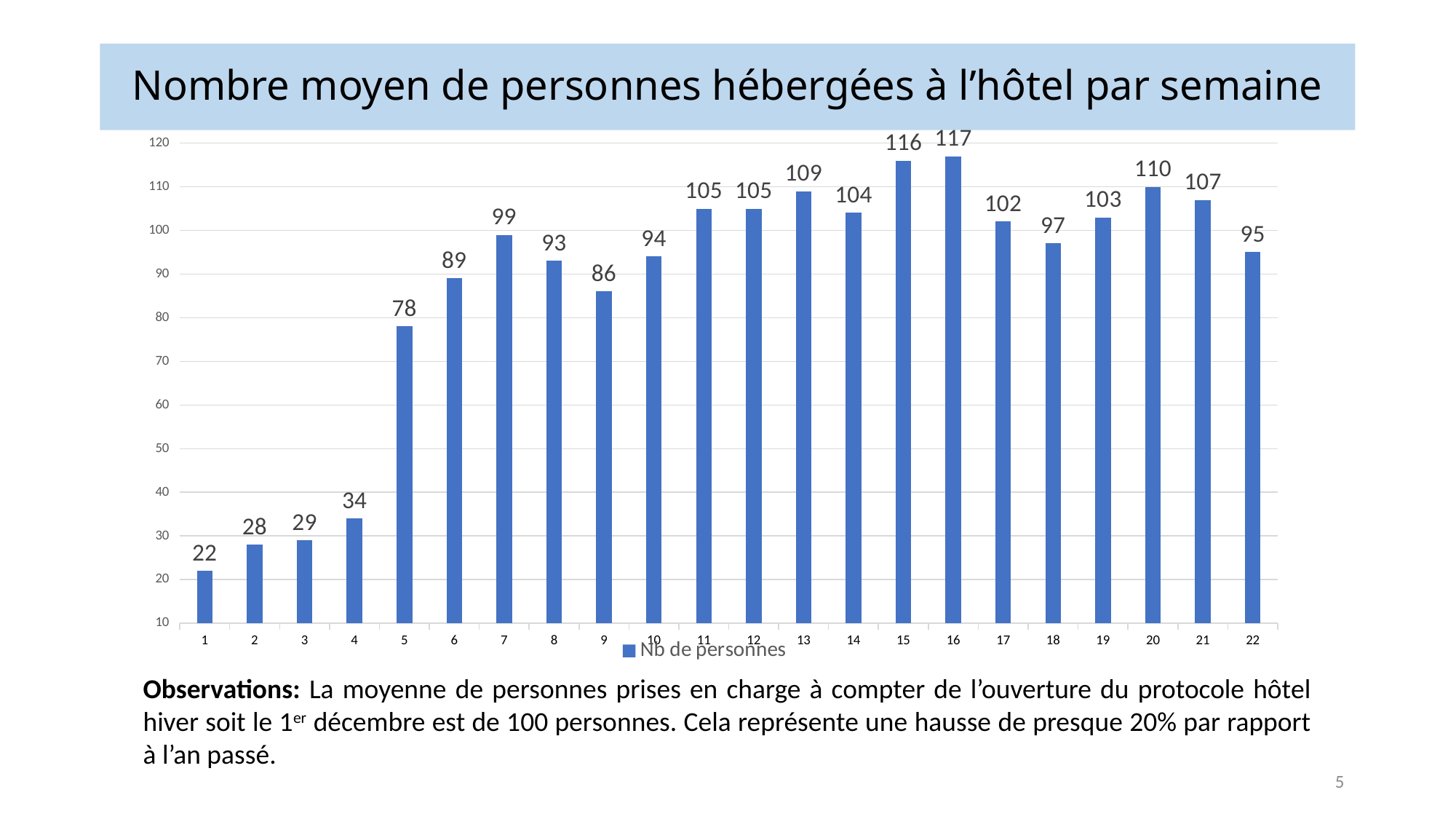
What is the value for week 5? 78 How many series does the legend list? 1 What is the difference between the values for week 5 and week 4? 44 What is the legend entry for the series? Nb de personnes Which is larger, the value for week 13 or the value for week 18? week 13 What is the value for week 22? 95 What kind of chart is shown? bar chart What is the value for week 16? 117 Which week has the lowest value? 1 Which week has the highest value? 16 How many weeks are shown on the x axis? 22 What is the difference between the values for week 16 and week 1? 95